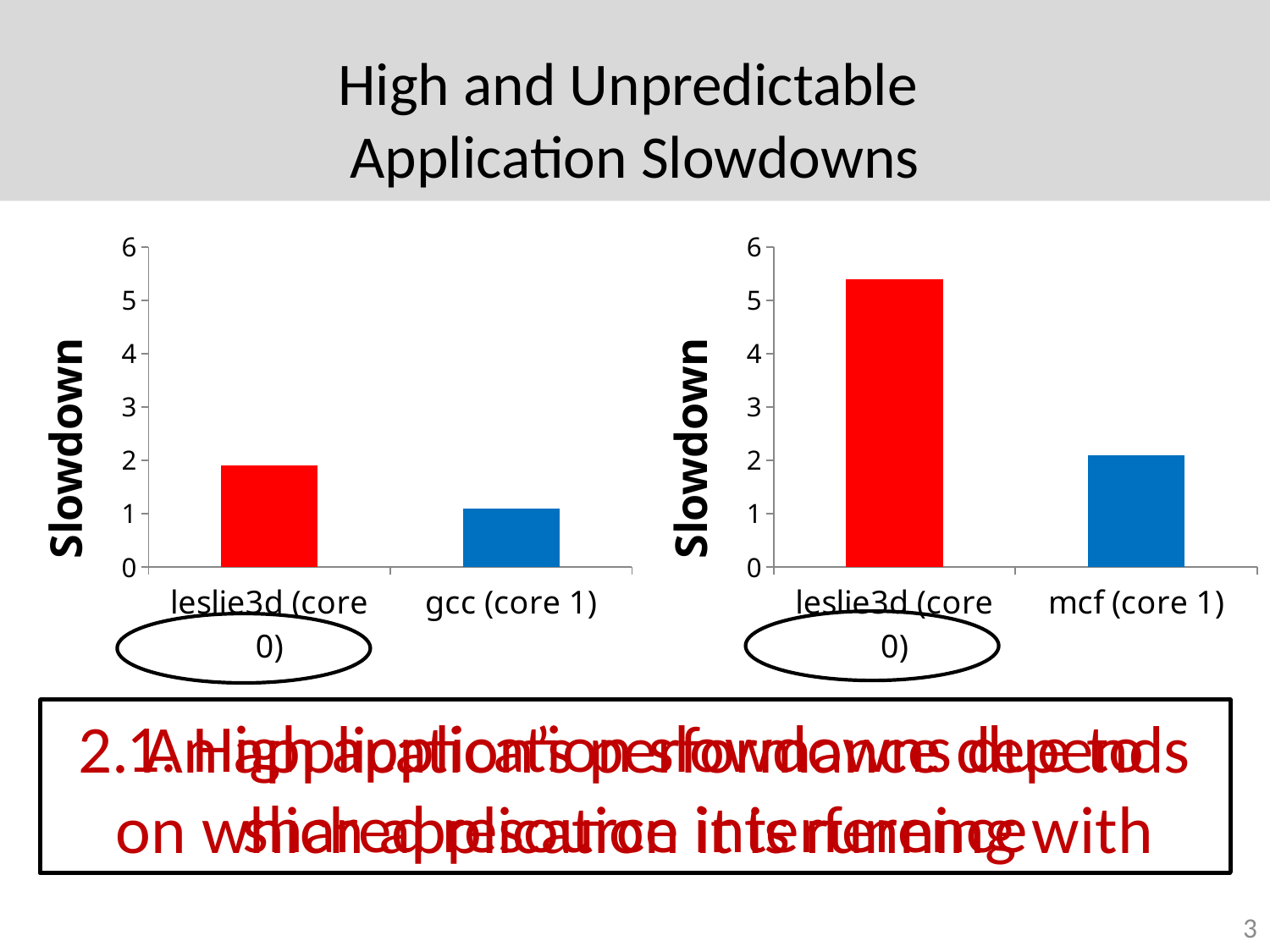
In the right chart, which category has the lower slowdown? mcf (core 1) In the right chart, is the slowdown for leslie3d (core 0) greater or less than 5? greater In the right chart, is the slowdown for mcf (core 1) greater or less than 3? less What kind of chart is the left chart on the slide? bar chart How many bars does the right chart show? 2 In the right chart, which category has the higher slowdown? leslie3d (core 0) How many bars does the left chart show? 2 What is the y-axis label on the left chart? Slowdown In the left chart, which category has the lower slowdown? gcc (core 1) Is the slowdown for leslie3d (core 0) larger in the left chart or in the right chart? right chart In the left chart, which category has the higher slowdown? leslie3d (core 0)